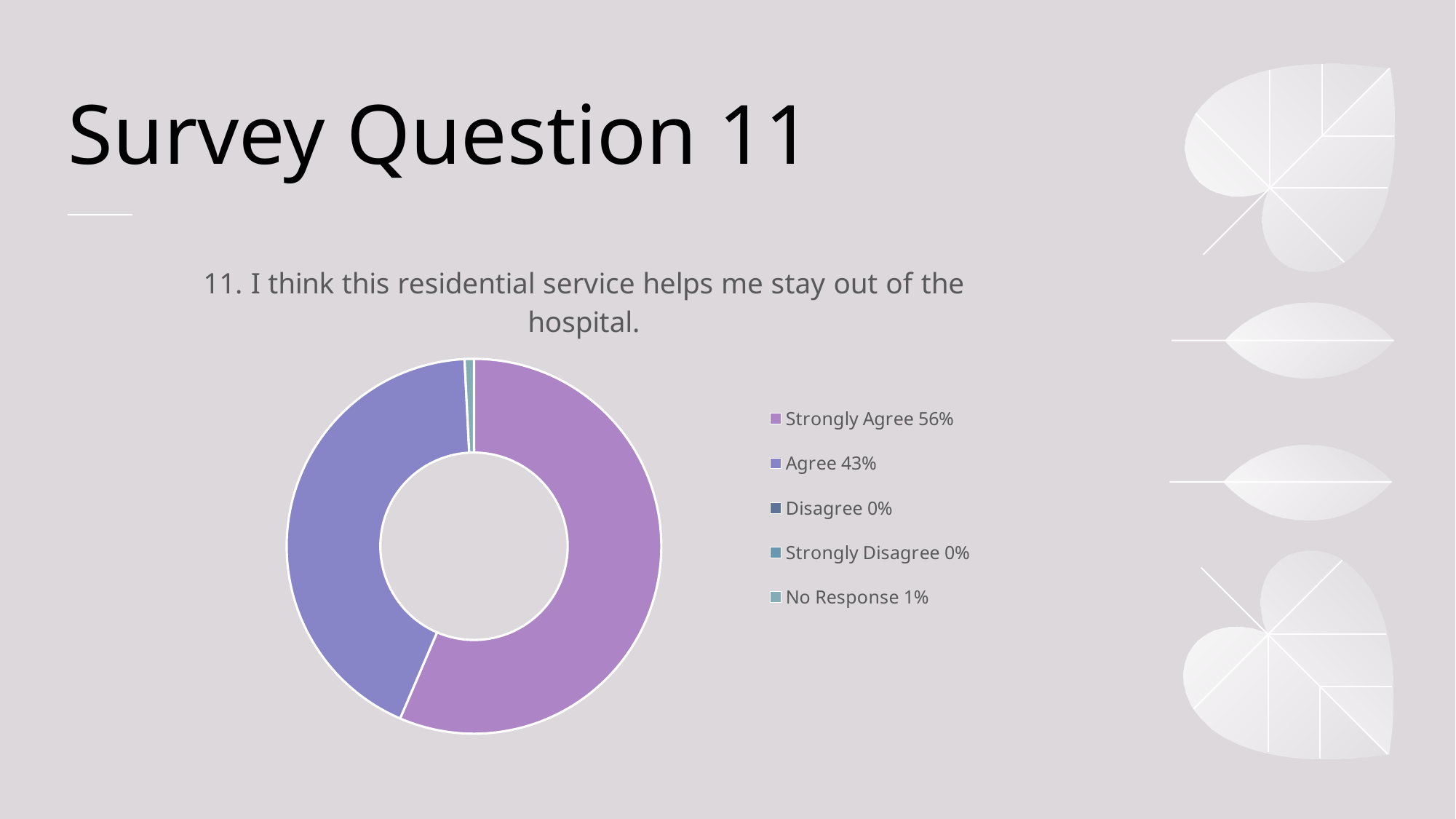
What percentage of respondents gave No Response? 1% What is the title of the chart? 11. I think this residential service helps me stay out of the hospital. What percentage of respondents answered Agree? 43% What is the difference in percentage points between Strongly Agree and Agree? 13 How many response categories does the legend list? 5 Which response category has the largest share? Strongly Agree What is the combined share of Strongly Agree and Agree? 99% What kind of chart is shown on the slide? Doughnut chart What percentage of respondents answered Strongly Agree? 56% What percentage of respondents answered Disagree? 0% Which legend entry is shown in the lightest purple colour? Strongly Agree 56% Which is larger, the share for Agree or the share for No Response? Agree